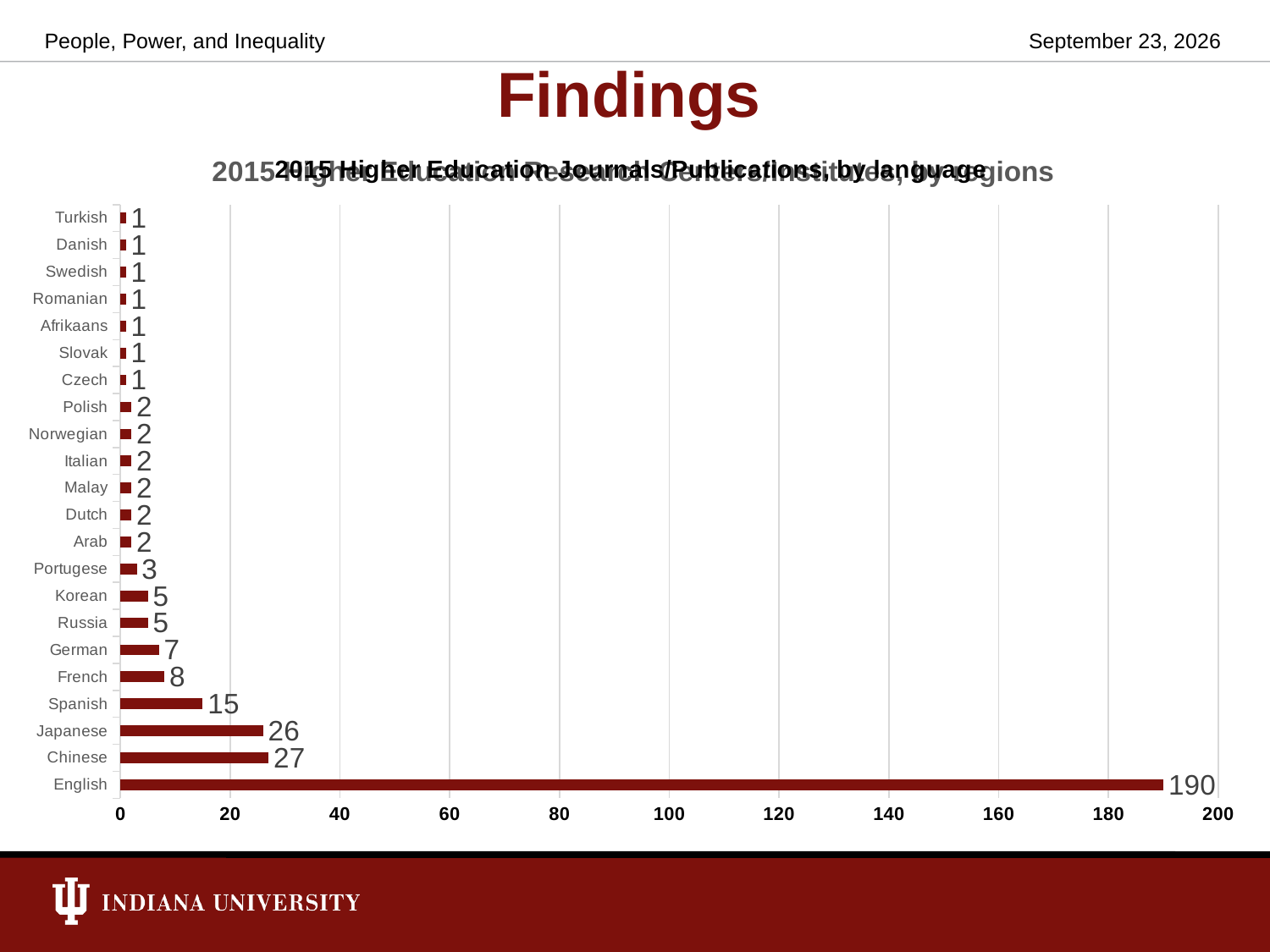
What is the value for Japanese? 26 What kind of chart is shown on the slide? bar chart Which language has the highest value? English What is the value for German? 7 What is the value for Chinese? 27 What is the value for Spanish? 15 What is the value for English? 190 Which has a larger value, Spanish or French? Spanish What is the difference between the values for French and Korean? 3 What is the difference between the values for English and Chinese? 163 How many languages are shown on the chart? 22 Is the value for English greater or less than 180? greater